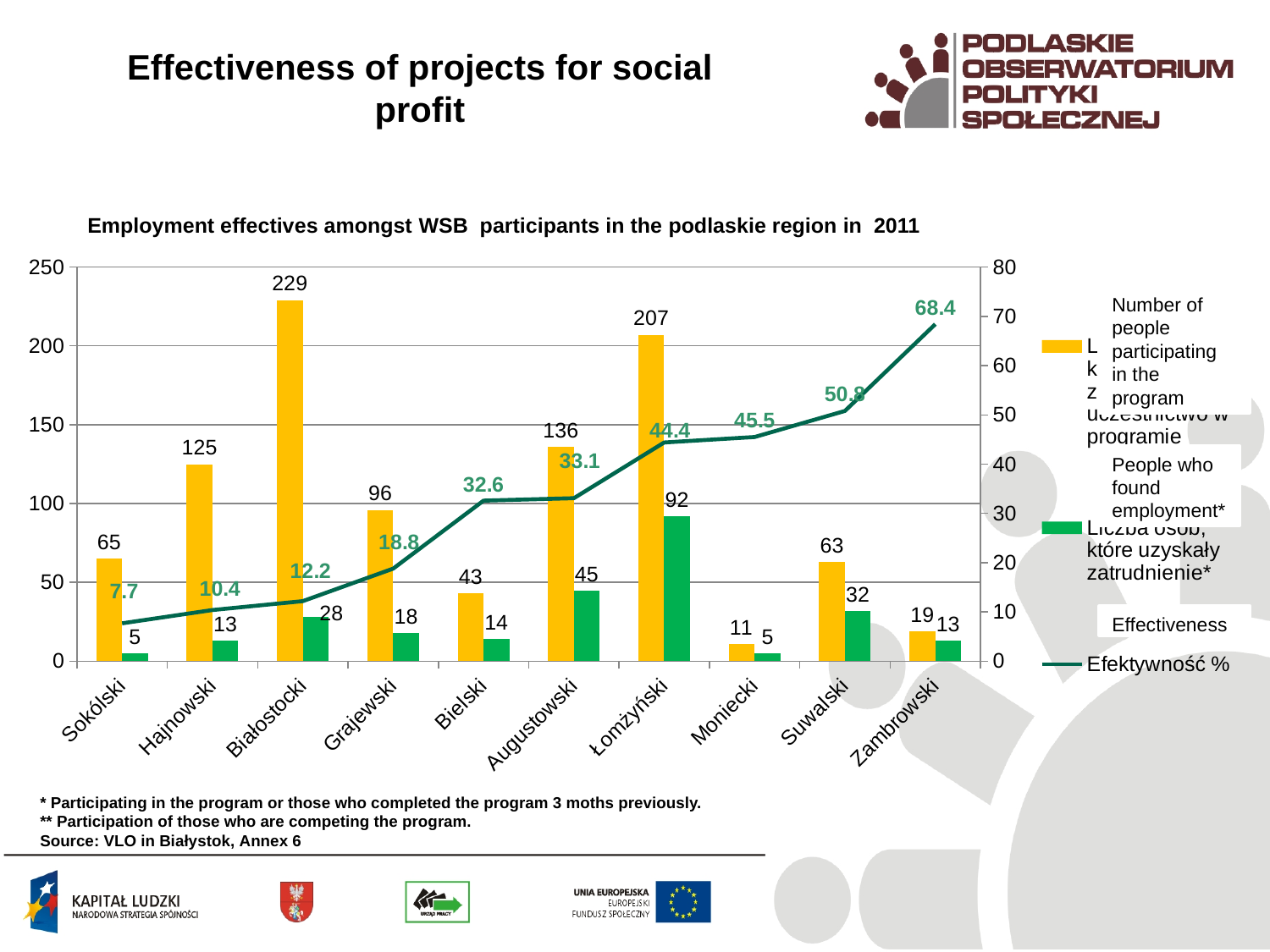
What is the effectiveness percentage for Sokólski? 7.7 What is the difference between the number of participants and the number who found employment in Łomżyński? 115 How many people found employment in Łomżyński? 92 Does the effectiveness line rise or fall from Sokólski to Zambrowski along the x axis? rises What is the effectiveness percentage for Zambrowski? 68.4 How many people participated in the program in Białostocki? 229 Which region had the highest number of people who found employment? Łomżyński How many series does the chart's legend list? 3 Which region had the lowest number of people participating in the program? Moniecki Which region had the highest number of people participating in the program? Białostocki Which region had more people participating in the program, Hajnowski or Augustowski? Augustowski How many regions are shown on the x axis of the chart? 10